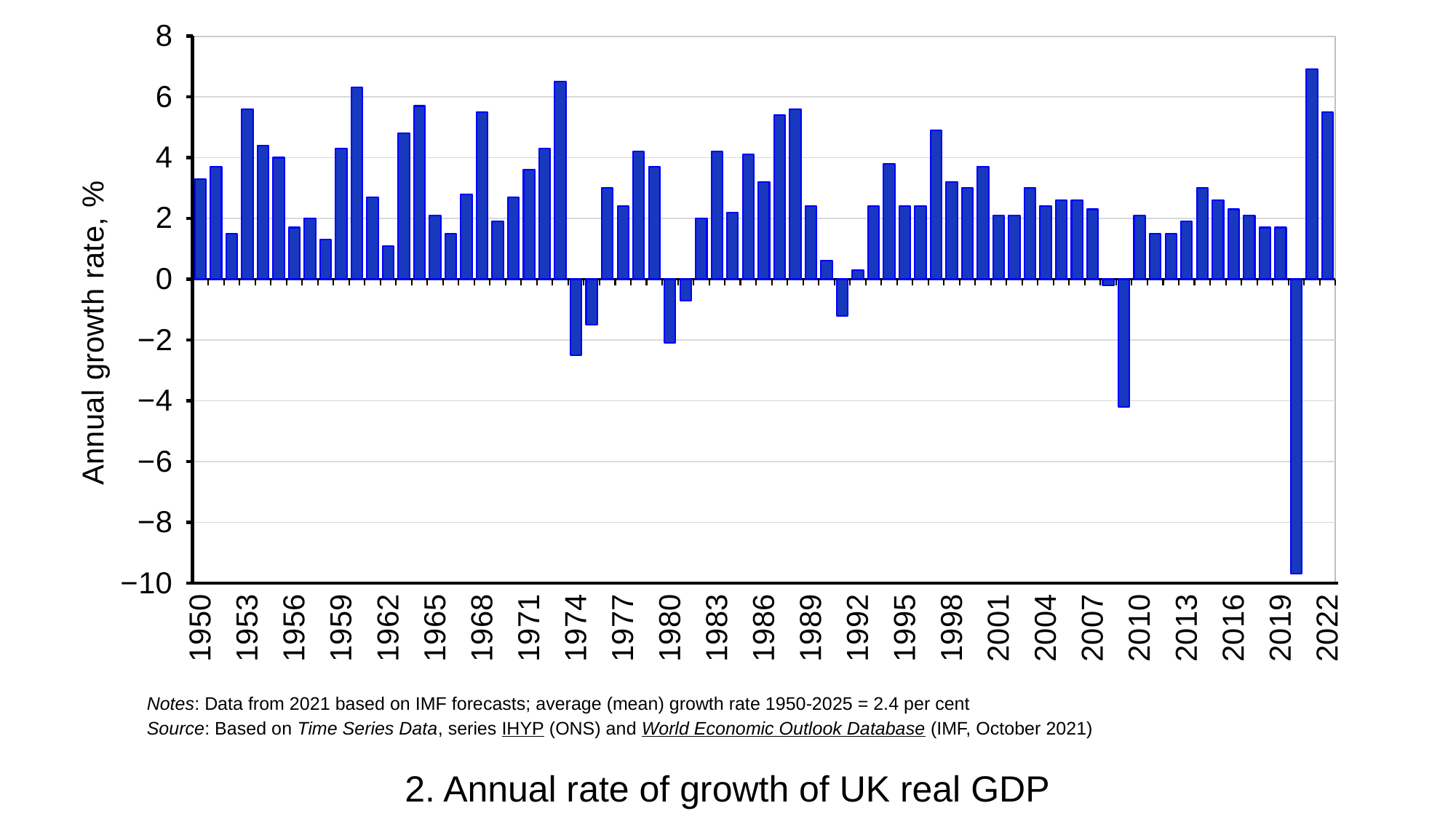
Which year has the highest annual growth rate in the chart? 2021 What is the title of the vertical axis? Annual growth rate, % Is the value for 2020 greater or less than -8? less Is the value for 2022 greater or less than 4? greater Is the value for 1974 greater or less than 0? less Which year has the larger growth rate, 2021 or 2022? 2021 Which year has the larger growth rate, 2009 or 2020? 2009 What kind of chart is shown on the slide? bar chart Which year has the lowest annual growth rate in the chart? 2020